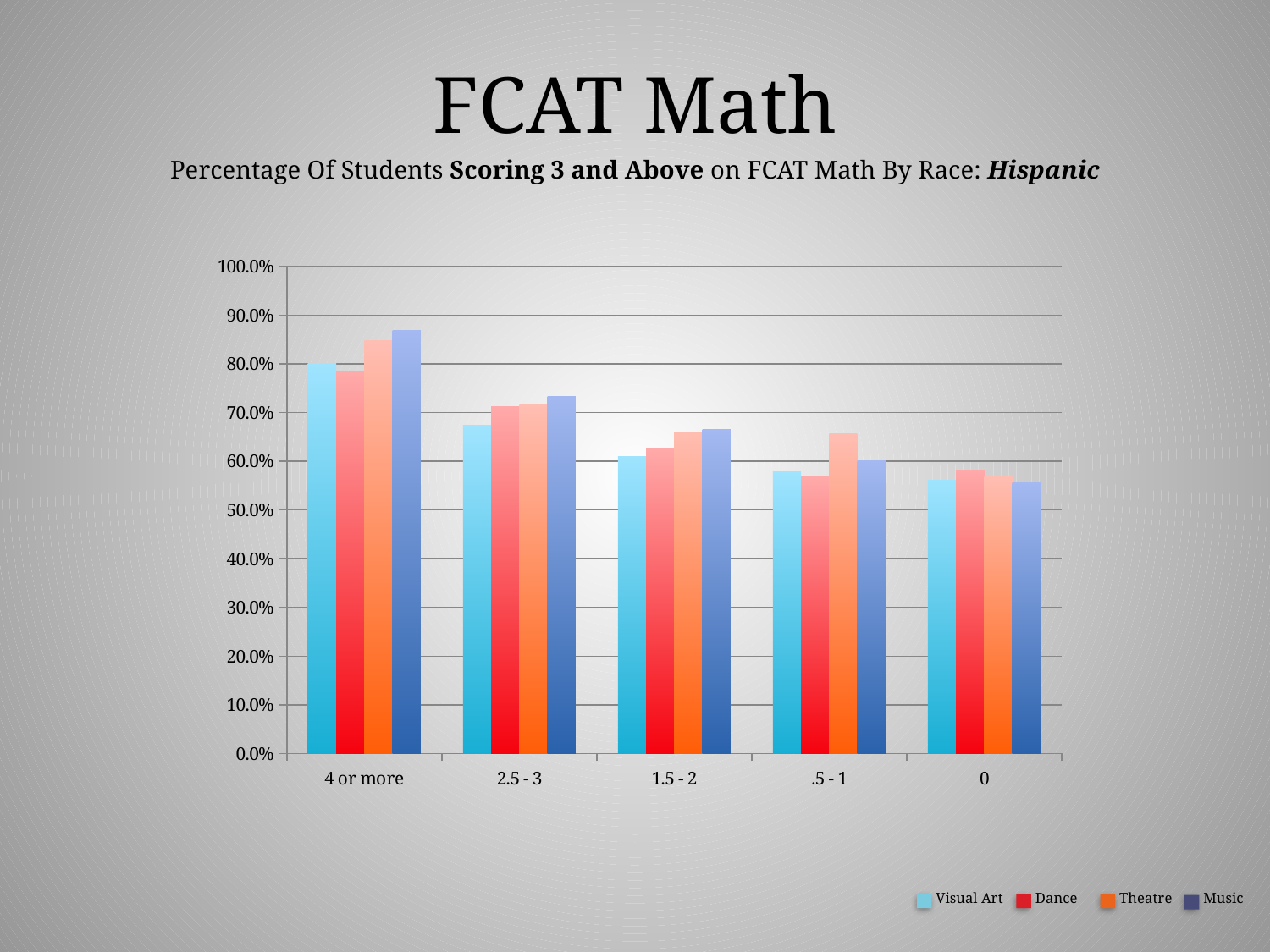
In the "4 or more" category, which is larger: Music or Visual Art? Music Is the value for Theatre in the ".5 - 1" category greater or less than 60.0%? greater How many series does the legend list? 4 What kind of chart is shown on the slide? bar chart In which category is the Music value highest? 4 or more In the ".5 - 1" category, which is larger: Theatre or Dance? Theatre How many categories are shown on the x axis? 5 Is the value for Visual Art in the "0" category greater or less than 60.0%? less Is the value for Visual Art in the "2.5 - 3" category greater or less than 70.0%? less Do the Music values rise or fall moving from "4 or more" to "0" along the x axis? fall Which series is shown in light blue in the legend? Visual Art